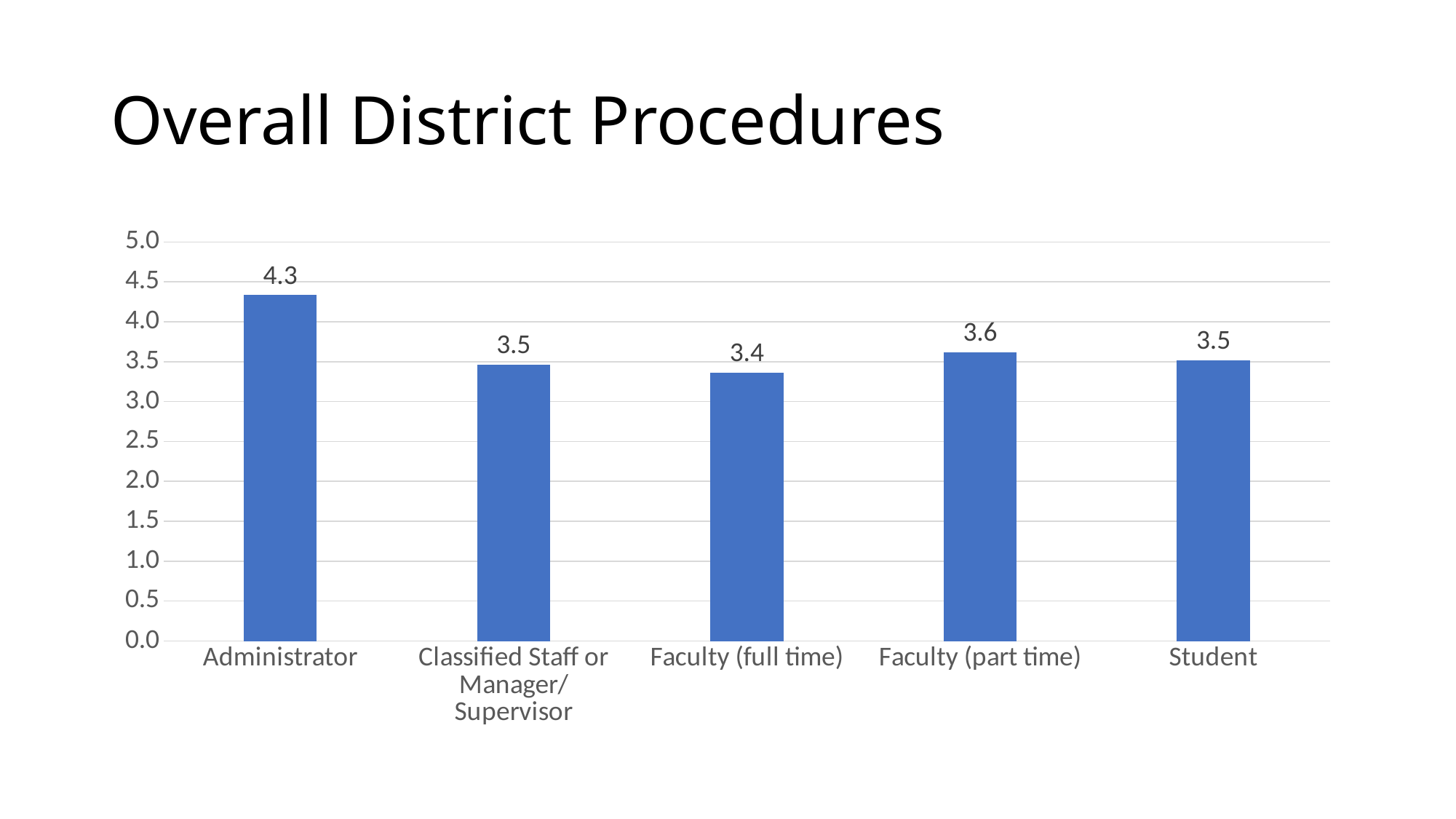
What is the value for Administrator? 4.3 What is the value for Faculty (part time)? 3.6 What kind of chart is shown on the slide? bar chart What is the value for Student? 3.5 How many categories are shown on the x axis? 5 What is the value for Faculty (full time)? 3.4 Which category has the highest value? Administrator Which is larger, the value for Administrator or the value for Faculty (part time)? Administrator Is the value for Administrator greater or less than 4.0? greater Which category has the lowest value? Faculty (full time) What is the difference between the values for Administrator and Faculty (full time)? 0.9 What is the title of the slide? Overall District Procedures